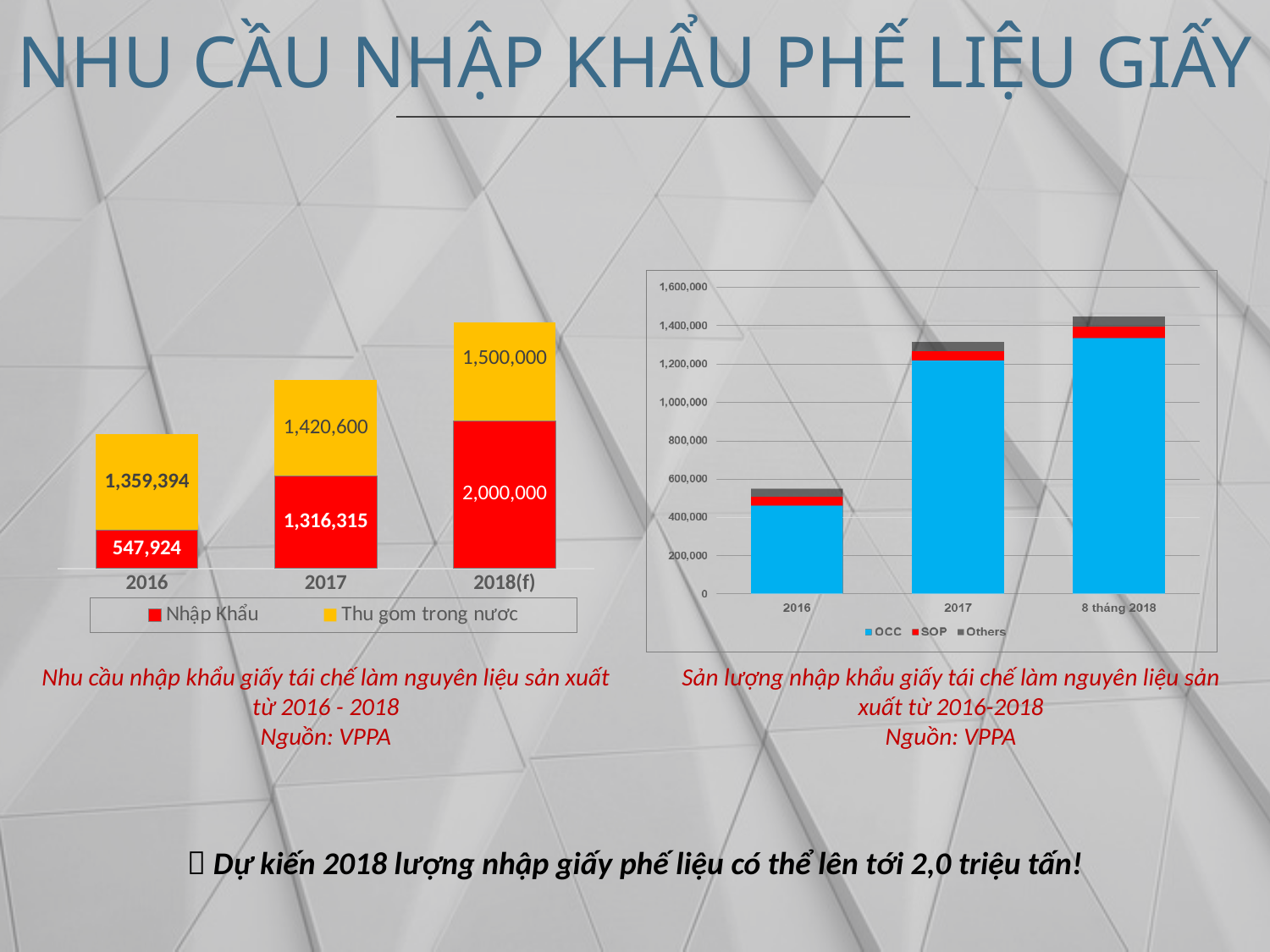
In the left chart, what is the Thu gom trong nước value for 2017? 1,420,600 In the left chart, what is the difference between the Nhập Khẩu values for 2017 and 2016? 768,391 In the left chart, which year has the lowest Thu gom trong nước value? 2016 How many series does the legend of the right chart list? 3 In the left chart, which year has the highest Nhập Khẩu value? 2018(f) In the left chart, does the Nhập Khẩu value rise or fall from 2016 to 2018(f)? rise In the right chart, is the OCC value for 2017 greater or less than 1,000,000? greater In the left chart, what is the Nhập Khẩu value for 2018(f)? 2,000,000 What kind of chart is the right chart? stacked bar chart In the left chart, is the Nhập Khẩu value for 2016 larger or smaller than the Thu gom trong nước value for 2016? smaller In the left chart, what is the total of the stacked bar for 2017? 2,736,915 In the left chart, what is the Nhập Khẩu value for 2016? 547,924